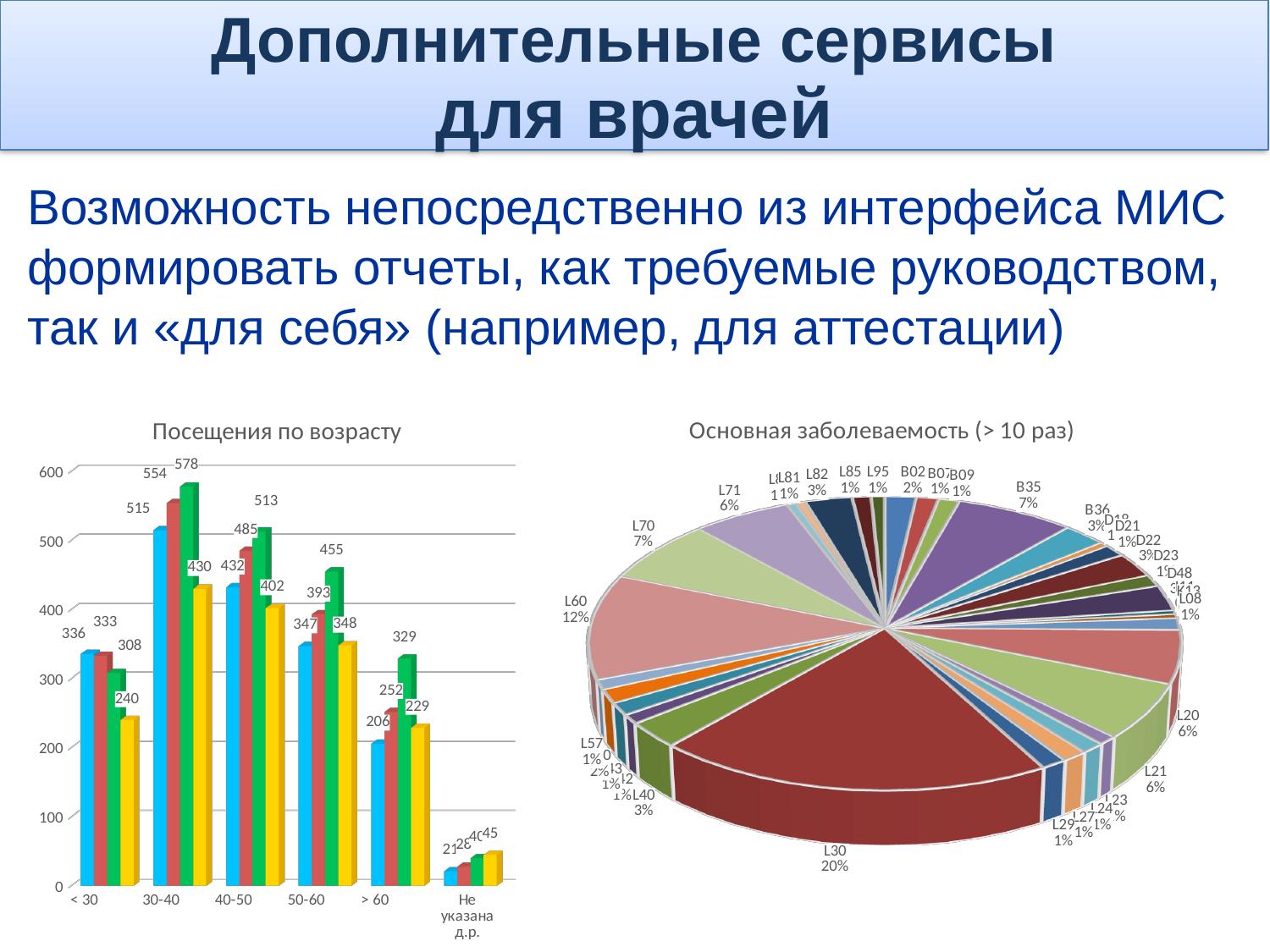
What kind of chart is the left chart titled "Посещения по возрасту"? bar chart In the chart "Посещения по возрасту", what is the difference between the green bar (578) and the blue bar (515) in the "30-40" category? 63 In the chart "Посещения по возрасту", how many age categories are shown on the x axis? 6 In the chart "Посещения по возрасту", what is the value of the green bar for the "40-50" category? 513 In the chart "Посещения по возрасту", what is the highest value shown on any bar? 578 In the pie chart "Основная заболеваемость (> 10 раз)", which slice is larger: L70 or L20? L70 In the chart "Посещения по возрасту", what is the value of the first (blue) bar for the "< 30" category? 336 In the chart "Посещения по возрасту", is the yellow bar for the "30-40" category greater or less than 400? greater In the chart "Посещения по возрасту", which is larger for the "50-60" category: the green bar or the yellow bar? the green bar (455) In the pie chart "Основная заболеваемость (> 10 раз)", which slice is the largest? L30 What kind of chart is the right chart titled "Основная заболеваемость (> 10 раз)"? pie chart In the pie chart "Основная заболеваемость (> 10 раз)", what share does L60 have? 12%